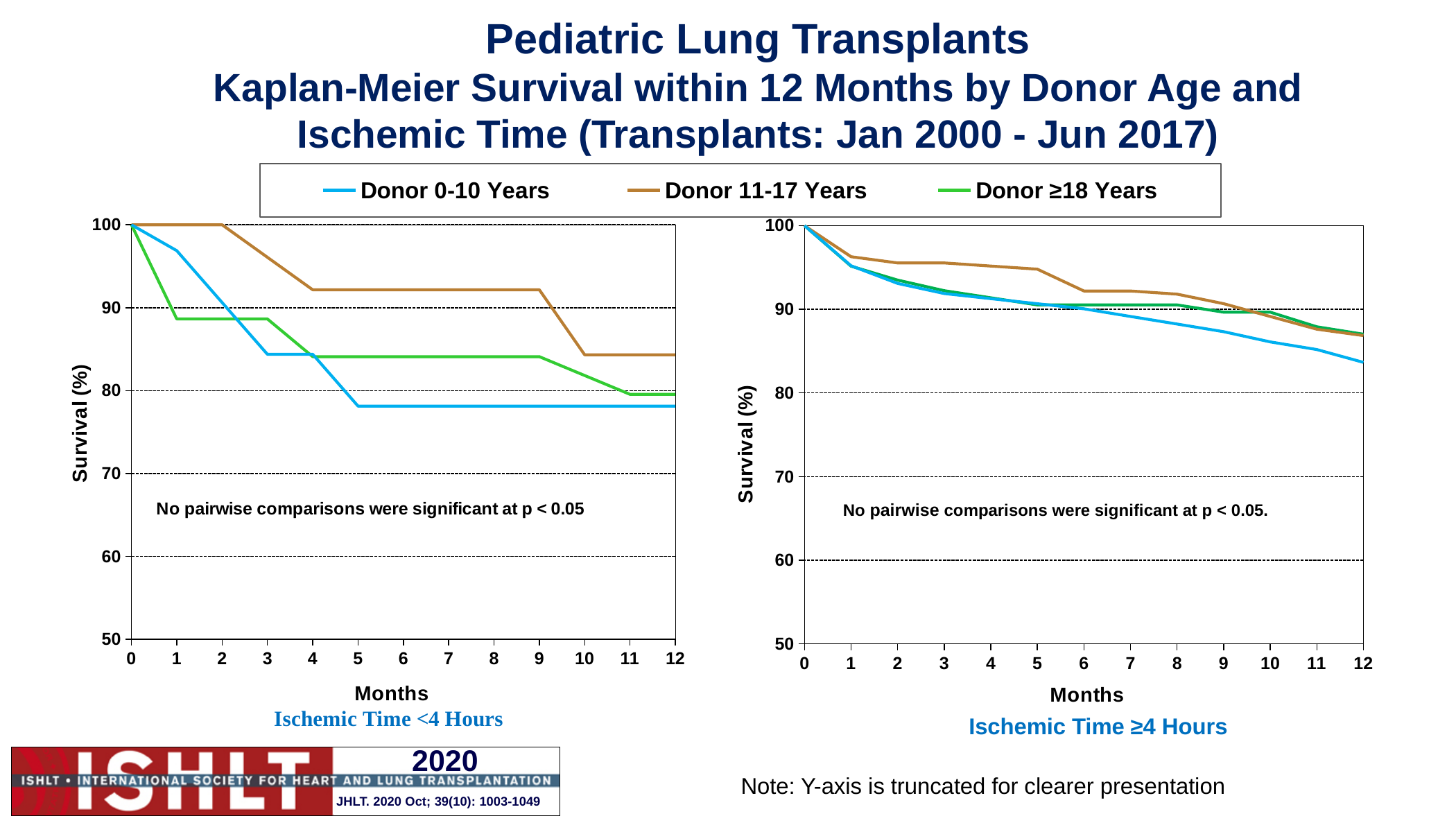
In the 'Ischemic Time <4 Hours' chart, is the survival value for Donor 11-17 Years at month 12 greater or less than 80? greater In the 'Ischemic Time <4 Hours' chart, what is the survival value for Donor 0-10 Years at month 0? 100 In the 'Ischemic Time <4 Hours' chart, is the survival value for Donor 0-10 Years at month 12 greater or less than 80? less In the 'Ischemic Time <4 Hours' chart, which is larger at month 2: the survival for Donor 11-17 Years or for Donor 0-10 Years? Donor 11-17 Years In the 'Ischemic Time <4 Hours' chart, which donor age group has the highest survival at month 12? Donor 11-17 Years What kind of chart is the 'Ischemic Time <4 Hours' chart on the left? line chart In the 'Ischemic Time ≥4 Hours' chart, do the survival curves rise or fall as months increase? fall In the 'Ischemic Time <4 Hours' chart, is the survival value for Donor 11-17 Years at month 6 greater or less than 90? greater What is the label of the y-axis on the 'Ischemic Time ≥4 Hours' chart? Survival (%) How many series does the legend list for the charts? 3 In the 'Ischemic Time ≥4 Hours' chart, which donor age group has the lowest survival at month 12? Donor 0-10 Years